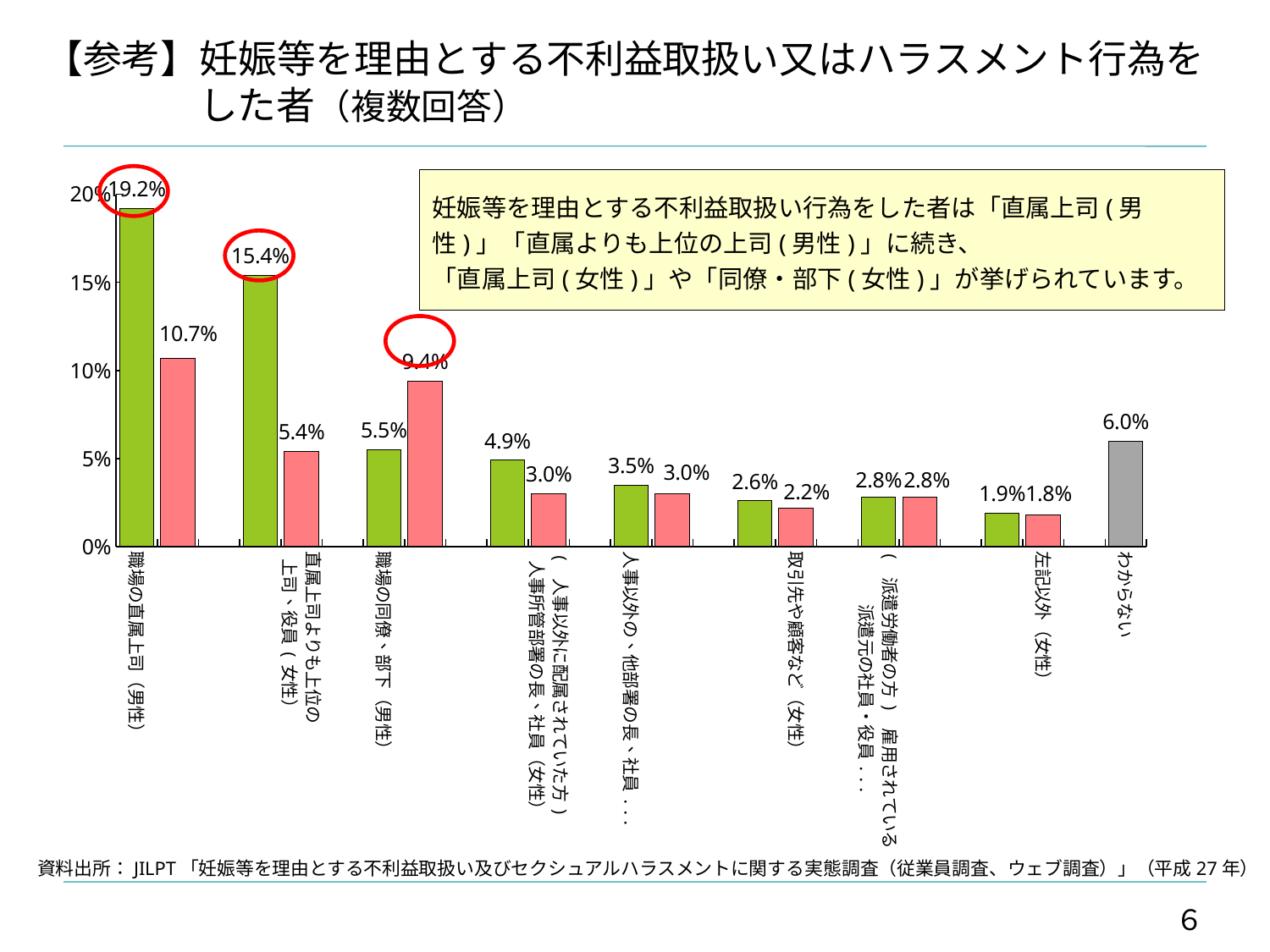
Which category has the lowest value? 左記以外（女性） What kind of chart is shown on the slide? bar chart What is the value for わからない? 6.0% What is the value for 職場の直属上司（男性）? 19.2% What is the value for 取引先や顧客など（女性）? 2.2% What is the value for 直属上司よりも上位の上司・役員（女性）? 5.4% How many bars are plotted in the chart? 17 Which category has the highest value? 職場の直属上司（男性） What is the value for 職場の同僚・部下（男性）? 5.5% What colour is the bar for わからない? gray Which is larger: the value for 職場の直属上司（男性） or the value for わからない? 職場の直属上司（男性） What is the difference between the highest value (19.2%) and the second highest value (15.4%)? 3.8 percentage points